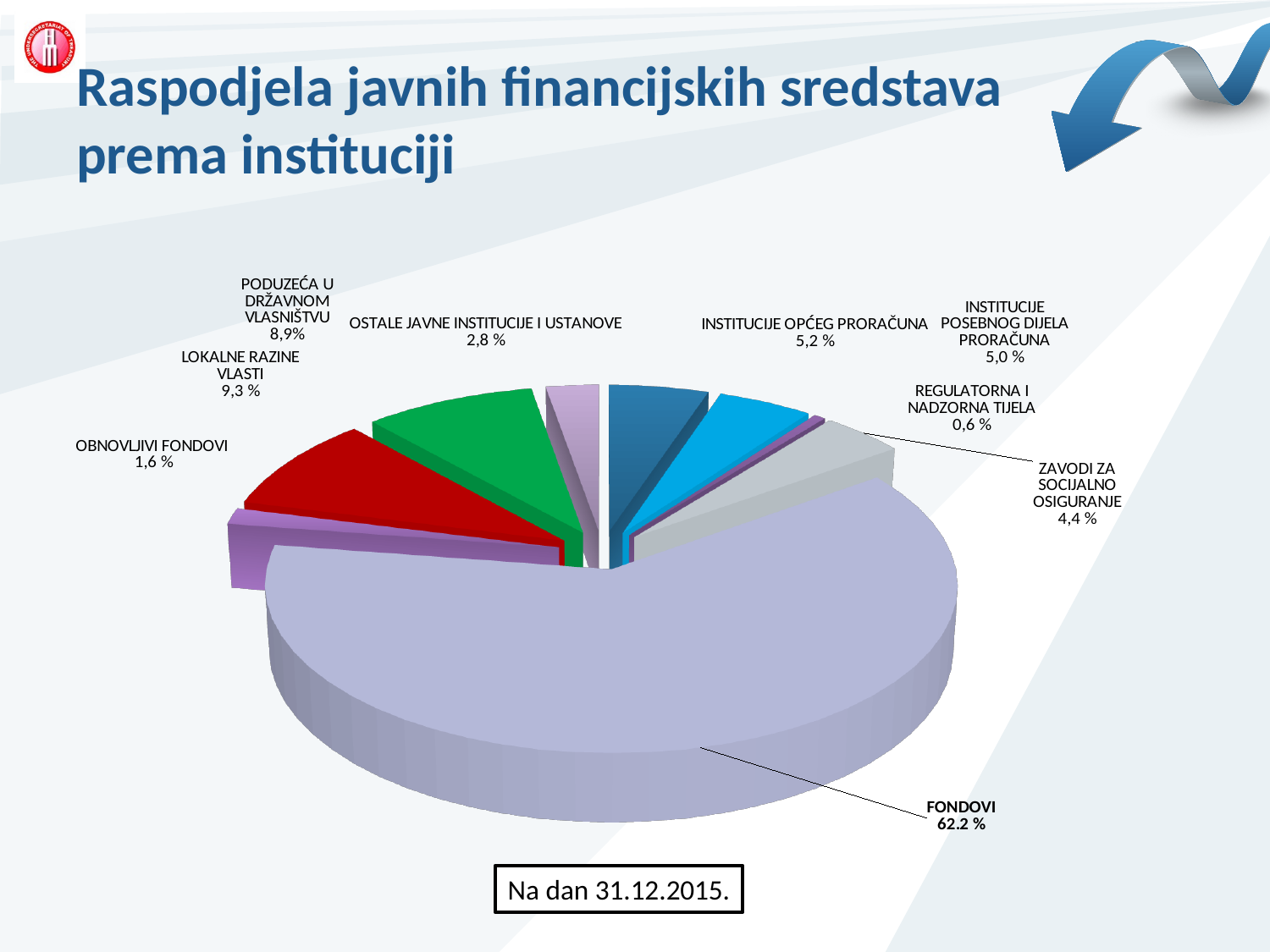
What is the difference between the values for LOKALNE RAZINE VLASTI and PODUZEĆA U DRŽAVNOM VLASNIŠTVU? 0,4 % What is the value shown for PODUZEĆA U DRŽAVNOM VLASNIŠTVU? 8,9% What is the value shown for REGULATORNA I NADZORNA TIJELA? 0,6 % What is the value shown for LOKALNE RAZINE VLASTI? 9,3 % What date is the chart data stated to be as of? 31.12.2015. Which is larger, INSTITUCIJE OPĆEG PRORAČUNA or INSTITUCIJE POSEBNOG DIJELA PRORAČUNA? INSTITUCIJE OPĆEG PRORAČUNA How many categories (slices) does the pie chart have? 9 Which category has the largest slice of the pie? FONDOVI What kind of chart is shown on the slide? pie chart What is the value shown for ZAVODI ZA SOCIJALNO OSIGURANJE? 4,4 % What share of the pie does FONDOVI have? 62.2 % Which category has the smallest slice of the pie? REGULATORNA I NADZORNA TIJELA